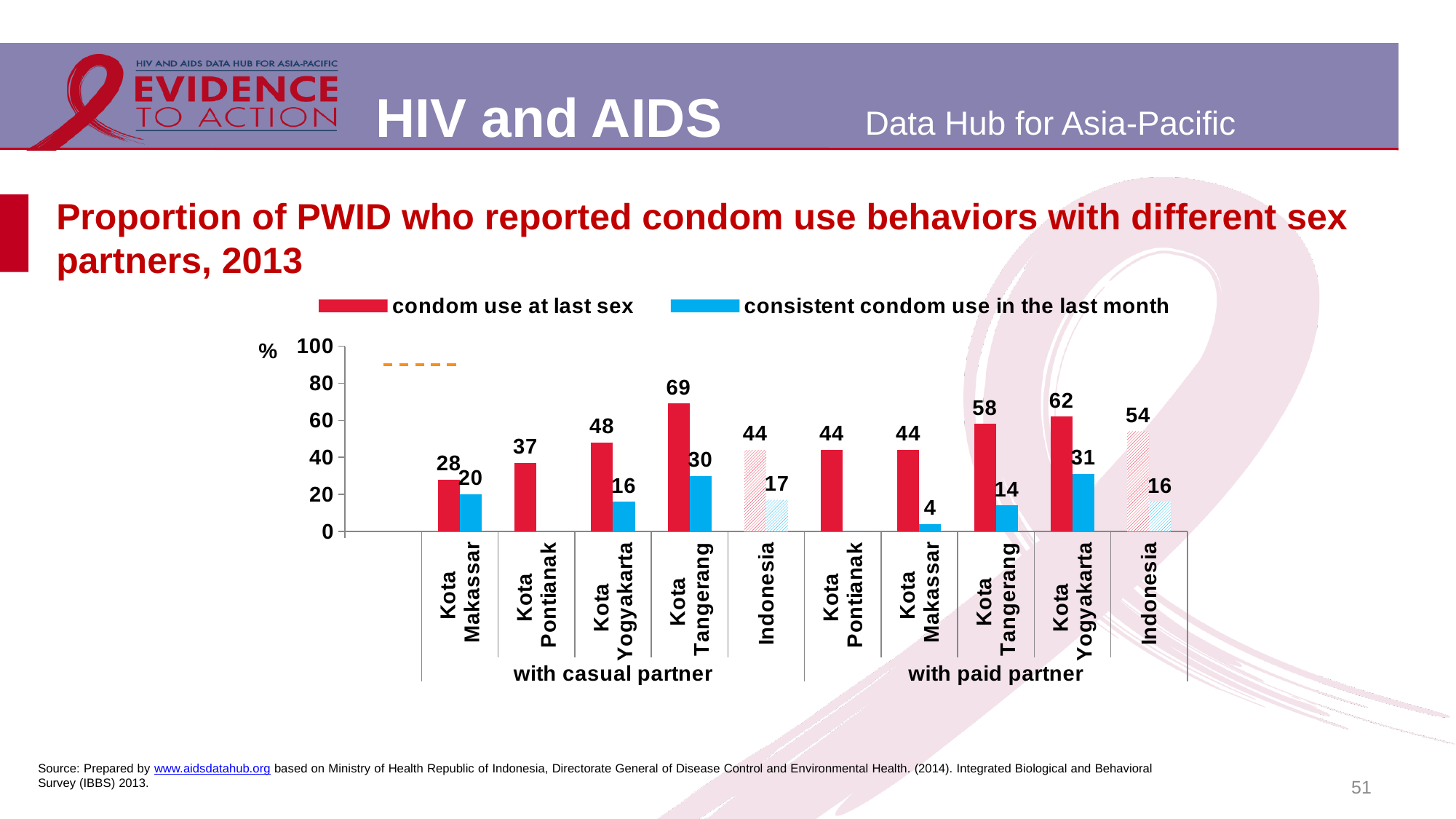
What is the value for condom use at last sex with paid partner for Indonesia? 54 Which is larger: condom use at last sex with casual partner in Kota Yogyakarta or in Kota Pontianak? Kota Yogyakarta Which location has the highest value for condom use at last sex with casual partner? Kota Tangerang What is the difference between condom use at last sex and consistent condom use in the last month with paid partner in Kota Yogyakarta? 31 What is the value for consistent condom use in the last month with paid partner in Kota Makassar? 4 What is the value for condom use at last sex with casual partner in Kota Tangerang? 69 What colour represents consistent condom use in the last month? blue Is the value for condom use at last sex with paid partner in Kota Tangerang greater or less than 40? greater How many location categories are shown under 'with paid partner'? 5 How many series does the legend list? 2 What kind of chart is shown on the slide? bar chart